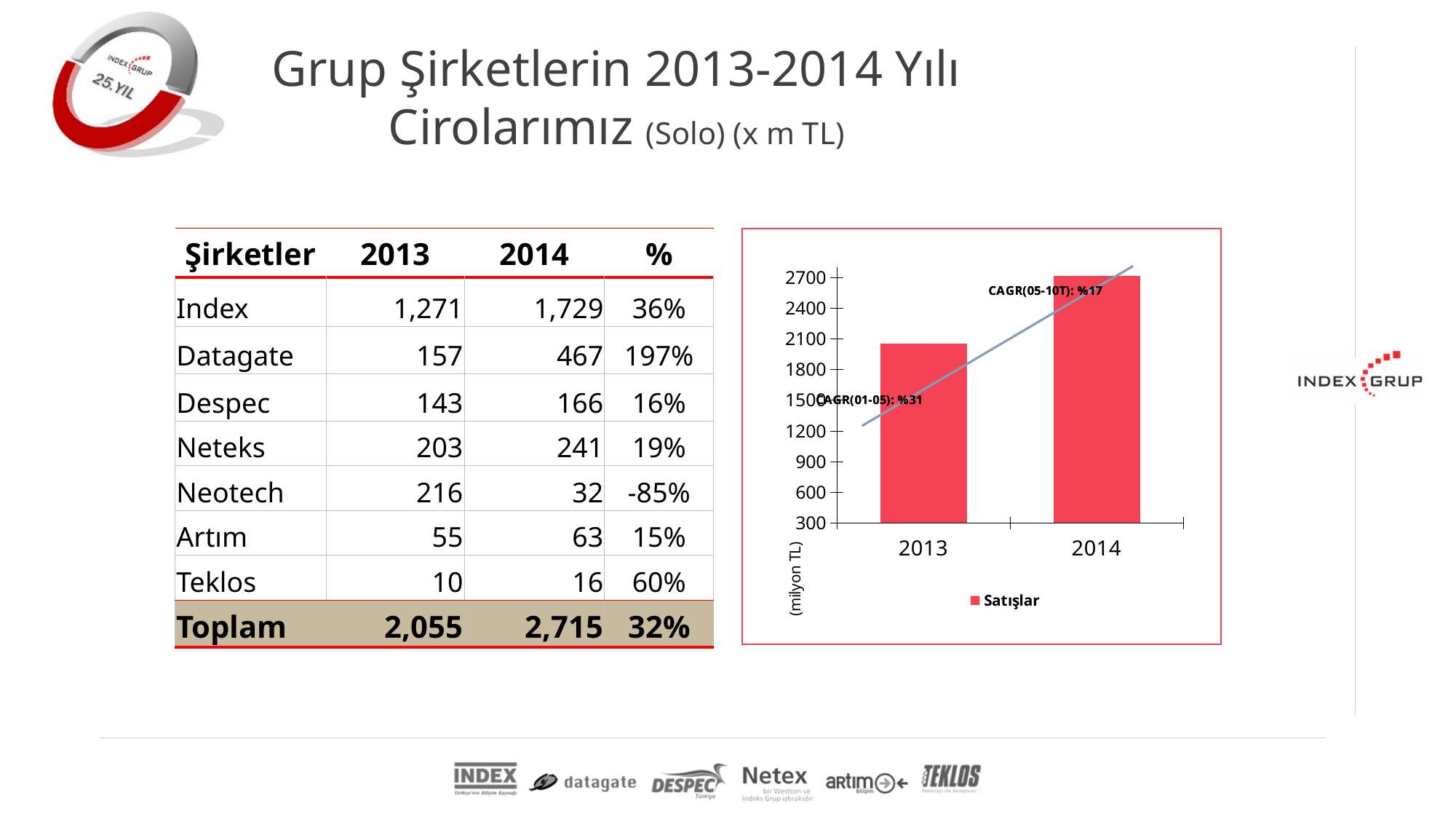
Which year has the highest bar in the chart? 2014 Which year has the taller bar in the chart, 2013 or 2014? 2014 How many series does the chart legend list? 1 What is the name of the series shown in the chart legend? Satışlar Is the value for 2013 in the chart greater or less than 1800? greater Which year has the lowest bar in the chart? 2013 What unit label is written along the vertical axis of the chart? (milyon TL) Is the value for 2014 in the chart greater or less than 2400? greater What kind of chart is shown on the slide? bar chart How many bars are plotted in the chart? 2 Do the values in the chart rise or fall from 2013 to 2014? rise